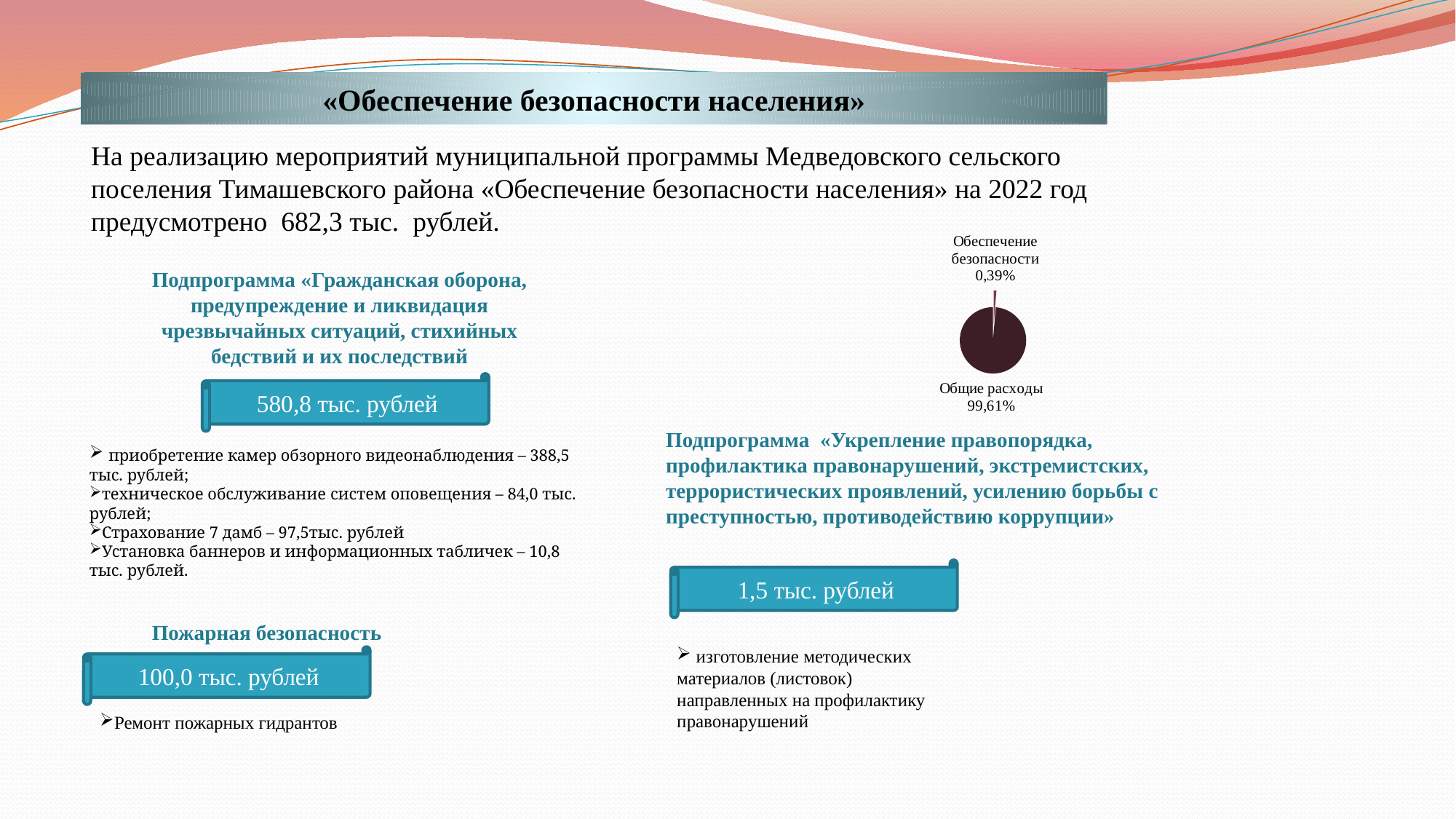
What colour is the «Общие расходы» slice of the pie chart? dark brown Which is larger in the pie chart: «Общие расходы» or «Обеспечение безопасности»? Общие расходы Which slice of the pie chart is the largest? Общие расходы What share of the pie chart does «Обеспечение безопасности» take? 0,39% How many slices does the pie chart have? 2 What is the label of the slice that takes 99,61% of the pie chart? Общие расходы What is the difference in percentage points between the «Общие расходы» slice and the «Обеспечение безопасности» slice? 99,22 What share of the pie chart does «Общие расходы» take? 99,61% What is the label of the slice that takes 0,39% of the pie chart? Обеспечение безопасности What kind of chart is shown on the slide? pie chart Which slice of the pie chart is the smallest? Обеспечение безопасности